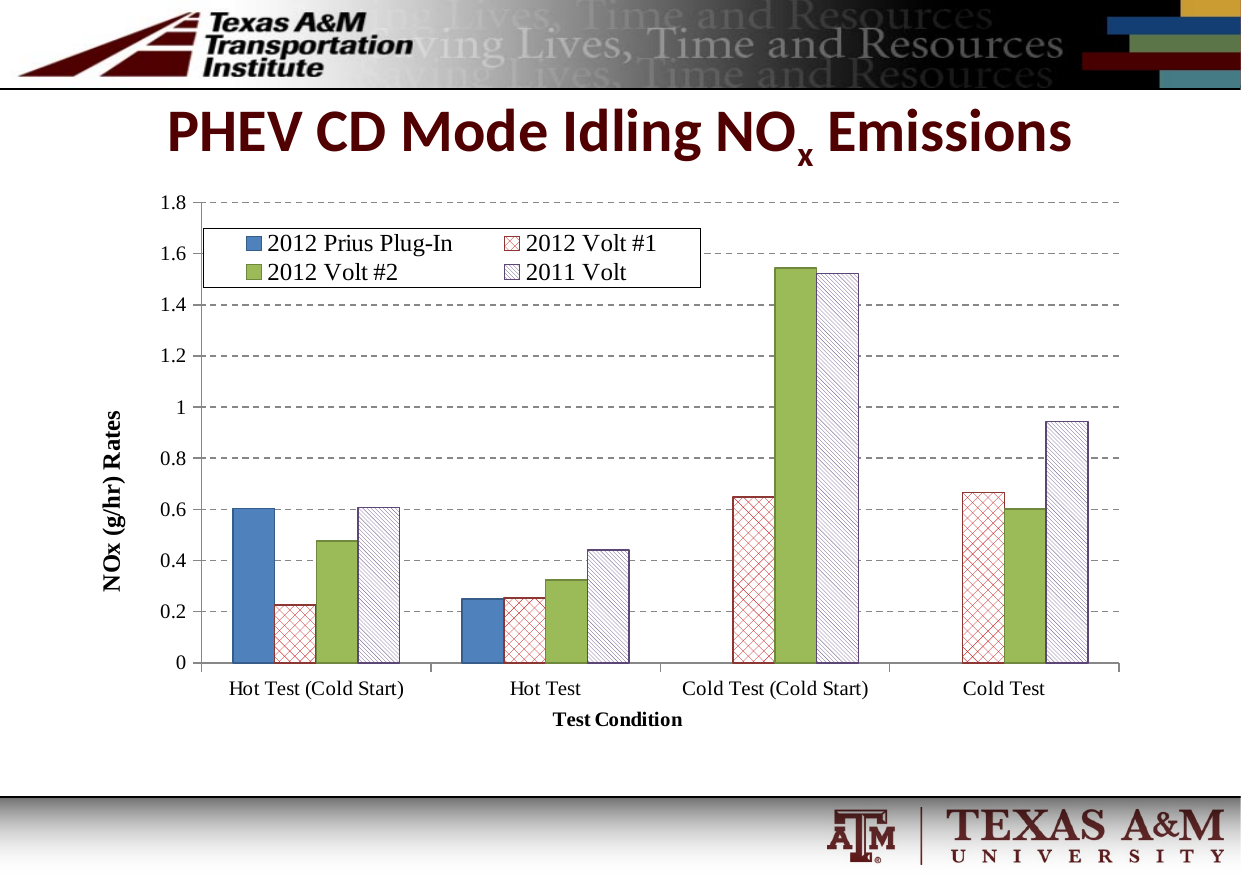
Under Hot Test (Cold Start), which is larger: the 2012 Prius Plug-In value or the 2012 Volt #2 value? 2012 Prius Plug-In How many series does the legend list? 4 For which test condition is the 2011 Volt value highest? Cold Test (Cold Start) What kind of chart is shown on the slide? bar chart Is the value for 2011 Volt under Cold Test greater or less than 0.8? greater Is the value for 2012 Volt #1 under Hot Test (Cold Start) greater or less than 0.4? less Under Hot Test, which is larger: the 2011 Volt value or the 2012 Volt #2 value? 2011 Volt How many test conditions are shown on the x axis? 4 What is the title of the y axis? NOx (g/hr) Rates For which test condition is the 2012 Volt #2 value lowest? Hot Test Is the value for 2012 Prius Plug-In under Hot Test greater or less than 0.4? less